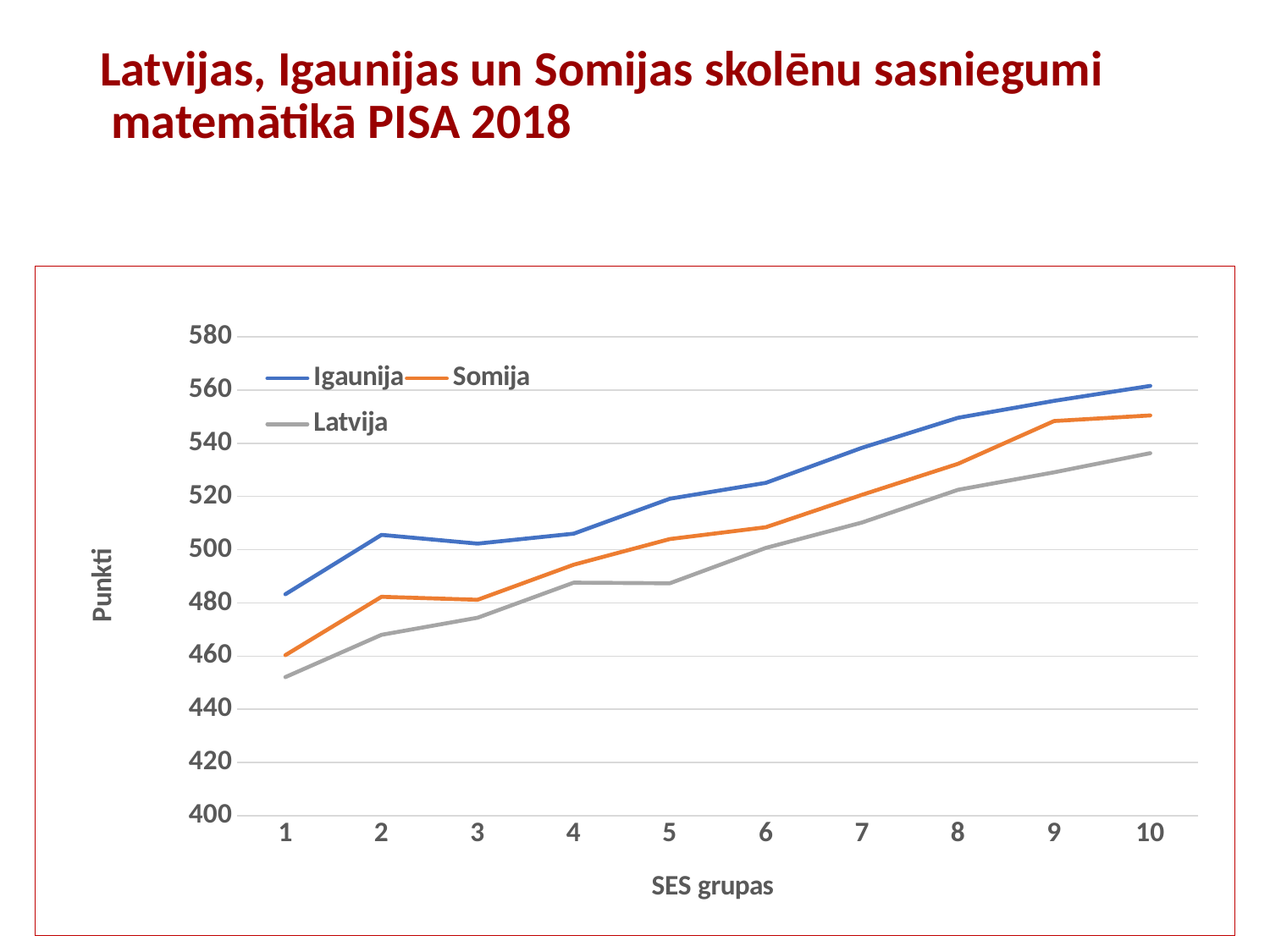
Is the value for Somija at SES group 1 greater or less than 480? less Which series has the highest value at SES group 10? Igaunija What kind of chart is shown on the slide? line chart Is the value for Igaunija at SES group 8 greater or less than 540? greater Which series has the lowest value at SES group 1? Latvija How many SES groups are shown on the x axis? 10 At which SES group does Latvija reach its highest value? 10 Is the value for Latvija at SES group 10 greater or less than 520? greater Do the values for Igaunija generally rise or fall as the SES group increases from 1 to 10? rise At SES group 2, which is larger: the value for Igaunija or the value for Somija? Igaunija What is the title of the vertical axis? Punkti How many series does the legend list? 3